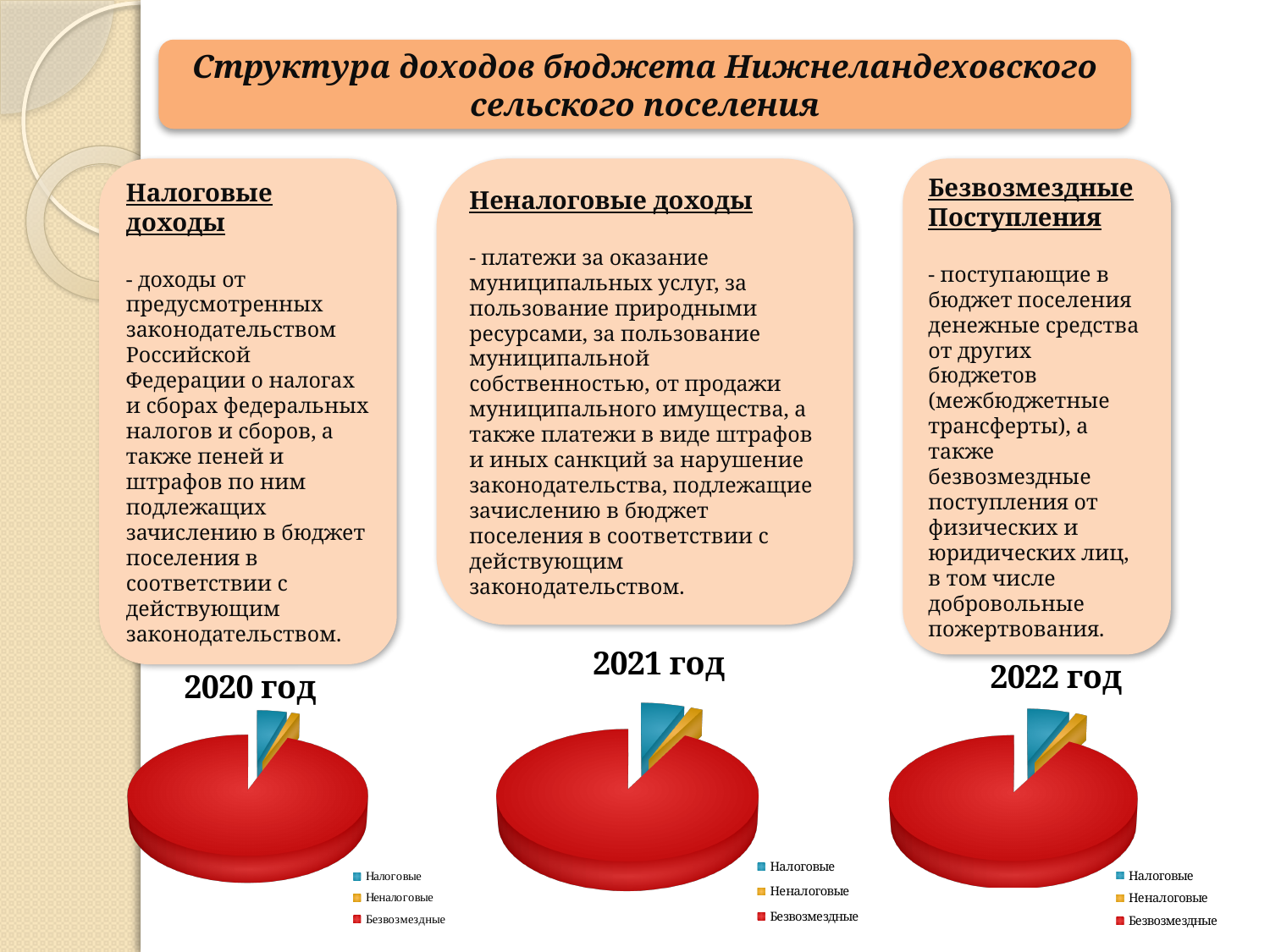
What is the title of the chart on the right of the slide? 2022 год In the "2021 год" chart, what colour represents Налоговые in the legend? blue What kind of chart is the "2022 год" chart? pie chart In the "2021 год" chart, which slice is larger: Безвозмездные or Неналоговые? Безвозмездные In the "2022 год" chart, which slice is larger: Налоговые or Безвозмездные? Безвозмездные What kind of chart is the "2020 год" chart? pie chart In the "2021 год" chart, which category has the largest slice? Безвозмездные In the "2020 год" chart, which category has the largest slice? Безвозмездные How many charts are shown on the slide? 3 In the "2020 год" chart, how many categories does the legend list? 3 In the "2022 год" chart, which category has the largest slice? Безвозмездные